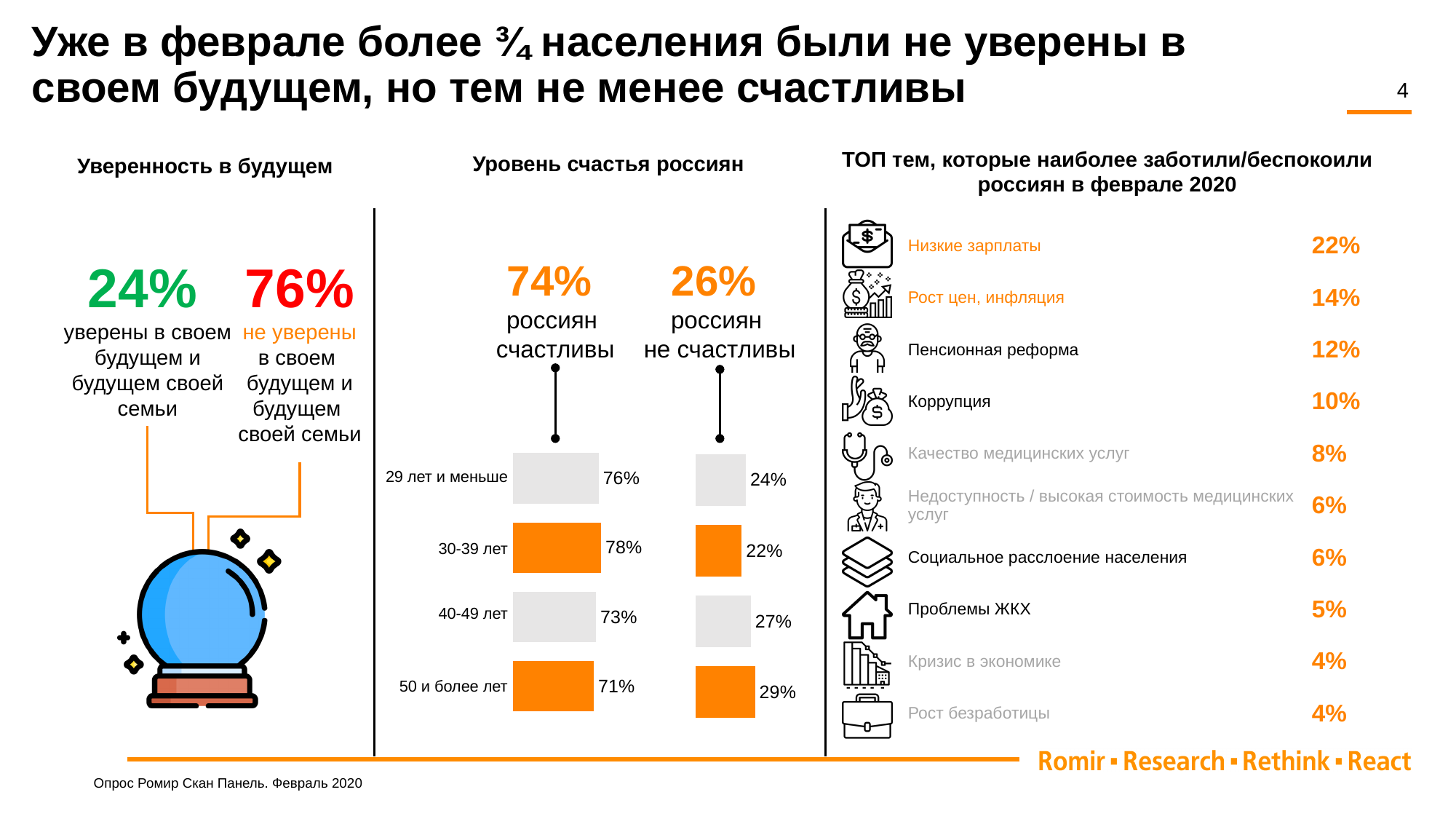
In the chart 'Уровень счастья россиян', which is larger: the not-happy share for '40-49 лет' or for '29 лет и меньше'? 40-49 лет In the chart 'Уровень счастья россиян', which age group has the lowest share of happy respondents? 50 и более лет In the chart 'Уровень счастья россиян', what is the difference between the happy share of '30-39 лет' and that of '50 и более лет'? 7% In the list 'ТОП тем, которые наиболее заботили/беспокоили россиян в феврале 2020', which topic has the highest value? Низкие зарплаты In the chart 'Уровень счастья россиян', which age group has the highest share of happy respondents? 30-39 лет In the chart 'Уровень счастья россиян', does the share of happy respondents rise or fall from the '30-39 лет' group to the '50 и более лет' group? fall In the chart 'Уровень счастья россиян', what share of the '30-39 лет' group is happy (счастливы)? 78% How many age groups are shown in the chart 'Уровень счастья россиян'? 4 In the chart 'Уровень счастья россиян', what share of the '50 и более лет' group is not happy (не счастливы)? 29% In the chart 'Уровень счастья россиян', what is the overall share of Russians who are happy? 74% What type of chart is 'Уровень счастья россиян'? bar chart In the list 'ТОП тем, которые наиболее заботили/беспокоили россиян в феврале 2020', what is the value for 'Пенсионная реформа'? 12%